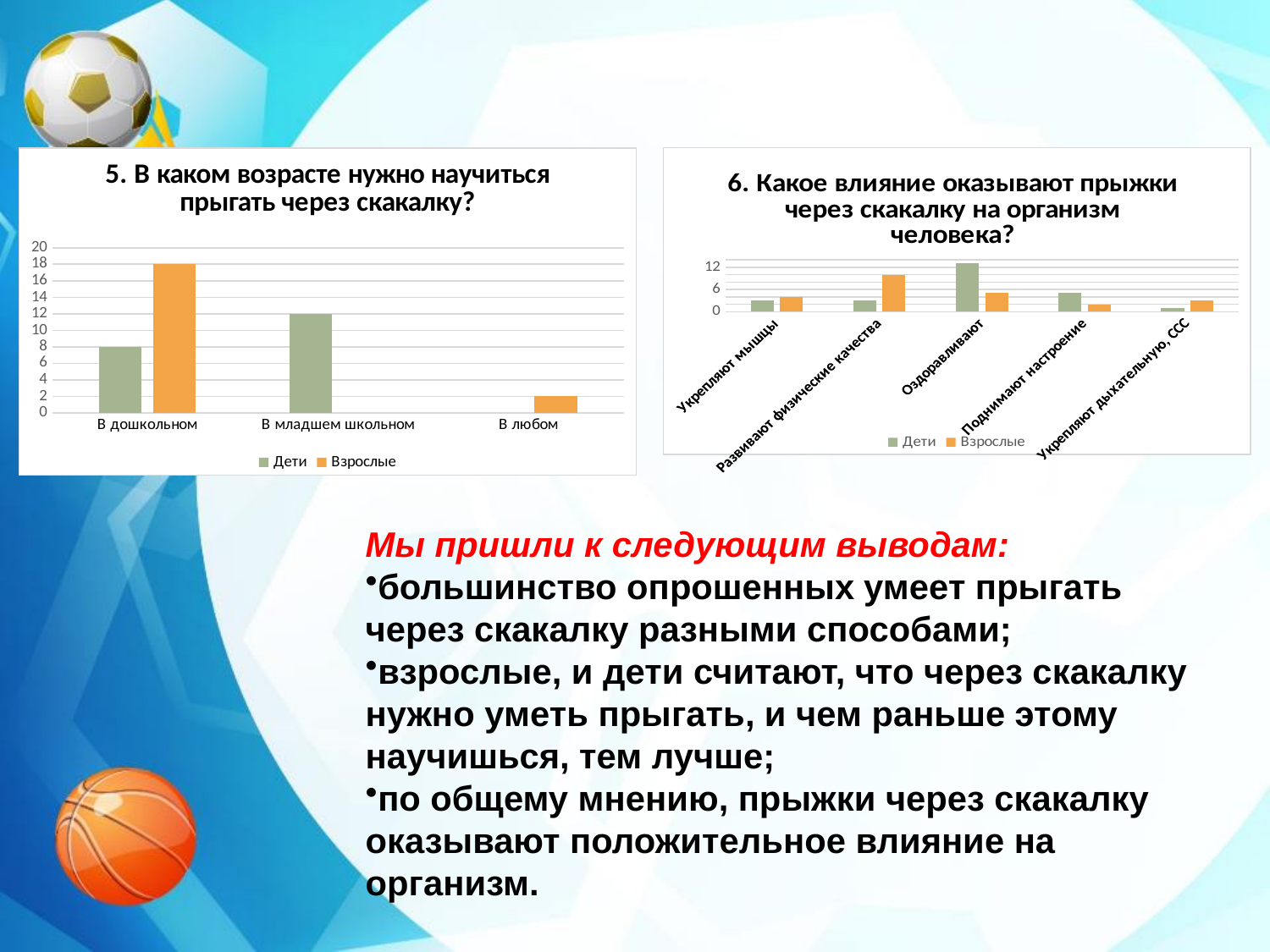
In the chart titled "5. В каком возрасте нужно научиться прыгать через скакалку?", what is the difference between the Взрослые and Дети values for В дошкольном? 10 In the chart titled "6. Какое влияние оказывают прыжки через скакалку на организм человека?", is the value for Взрослые in Развивают физические качества greater or less than 6? greater In the chart titled "6. Какое влияние оказывают прыжки через скакалку на организм человека?", which category has the highest value for Взрослые? Развивают физические качества In the chart titled "5. В каком возрасте нужно научиться прыгать через скакалку?", what is the value for Дети in the category В дошкольном? 8 In the chart titled "5. В каком возрасте нужно научиться прыгать через скакалку?", what is the value for Взрослые in the category В любом? 2 In the chart titled "5. В каком возрасте нужно научиться прыгать через скакалку?", how many categories are shown on the x axis? 3 In the chart titled "5. В каком возрасте нужно научиться прыгать через скакалку?", what is the value for Дети in the category В младшем школьном? 12 In the chart titled "5. В каком возрасте нужно научиться прыгать через скакалку?", what is the value for Взрослые in the category В дошкольном? 18 In the chart titled "6. Какое влияние оказывают прыжки через скакалку на организм человека?", how many series does the legend list? 2 What kind of chart is the one titled "6. Какое влияние оказывают прыжки через скакалку на организм человека?"? bar chart In the chart titled "5. В каком возрасте нужно научиться прыгать через скакалку?", which category has the highest value for Дети? В младшем школьном In the chart titled "6. Какое влияние оказывают прыжки через скакалку на организм человека?", which category has the highest value for Дети? Оздоравливают